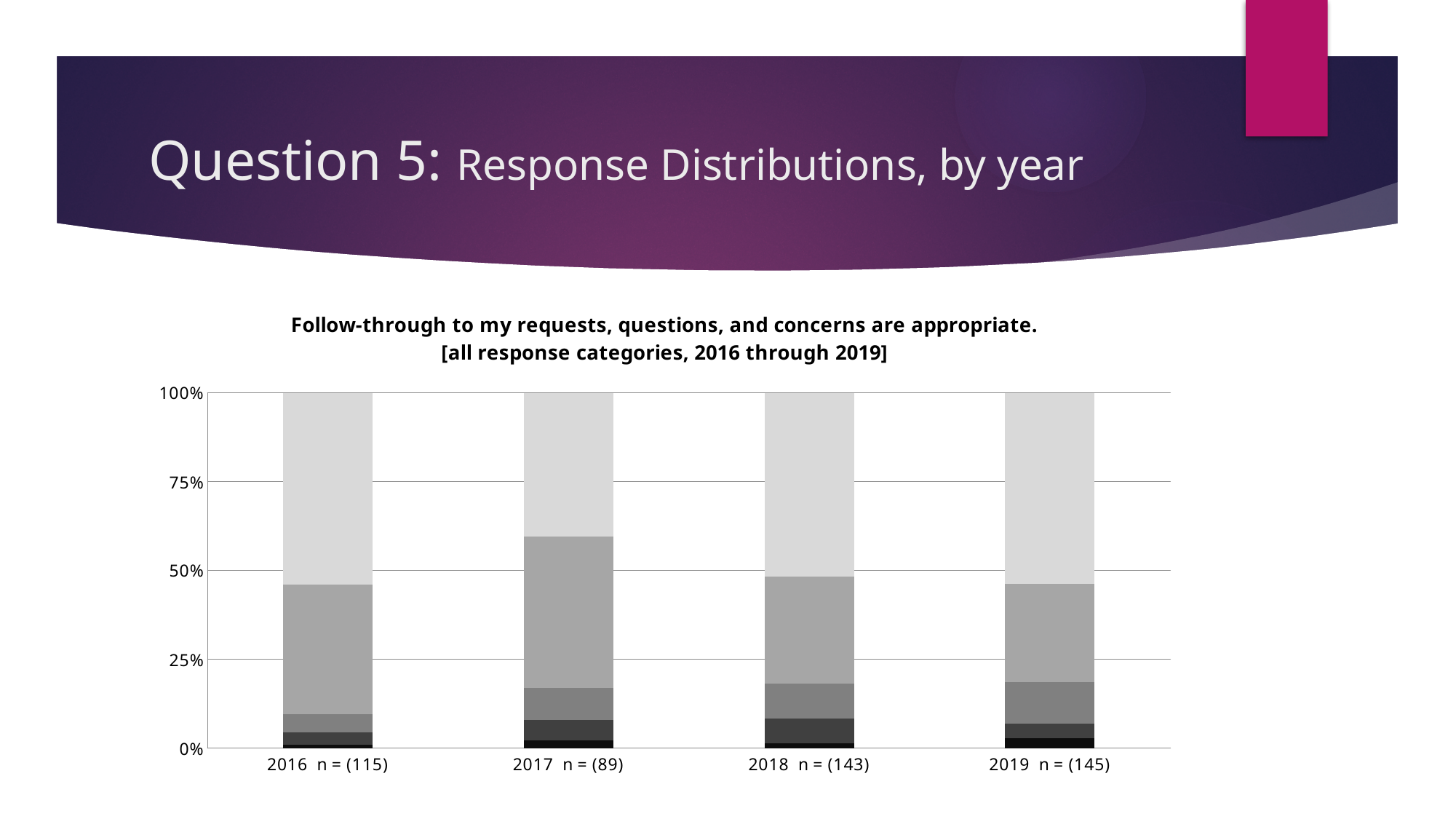
How many years (bars) are shown on the x axis? 4 In the 2016 bar, is the combined height of the segments below the lightest top segment greater or less than 50%? less Which year has the smallest sample size n? 2017 What is the sample size n shown for 2017? 89 What is the sample size n shown for 2016? 115 What does each stacked bar total on the y axis? 100% What kind of chart is shown on the slide? Stacked bar chart What is the sample size n shown for 2019? 145 In the 2017 bar, is the combined height of the segments below the lightest top segment greater or less than 50%? greater Which year has the largest sample size n? 2019 What is the first line of the chart title? Follow-through to my requests, questions, and concerns are appropriate. In which year is the lightest (top) segment of the bar the smallest? 2017